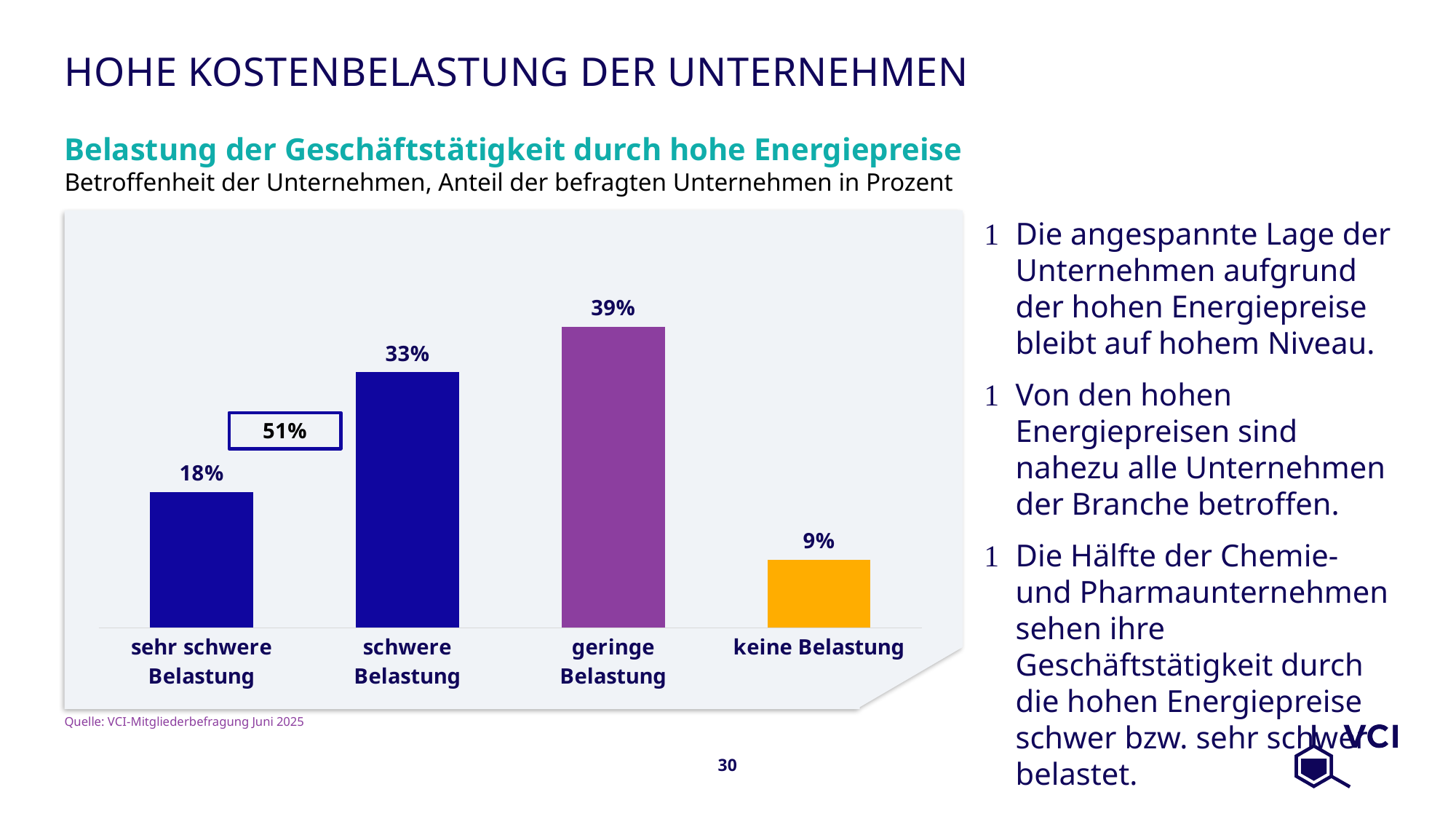
What is the value for "keine Belastung"? 9% What is the title of the chart? Belastung der Geschäftstätigkeit durch hohe Energiepreise How many categories are shown in the chart? 4 Which is larger, the value for "sehr schwere Belastung" or the value for "keine Belastung"? sehr schwere Belastung What combined value is shown in the box above the first two bars? 51% What is the value for "schwere Belastung"? 33% What is the difference between the values for "geringe Belastung" and "schwere Belastung"? 6% What is the value for "sehr schwere Belastung"? 18% What is the value for "geringe Belastung"? 39% Which category has the lowest value? keine Belastung What kind of chart is shown on the slide? bar chart Which category has the highest value? geringe Belastung